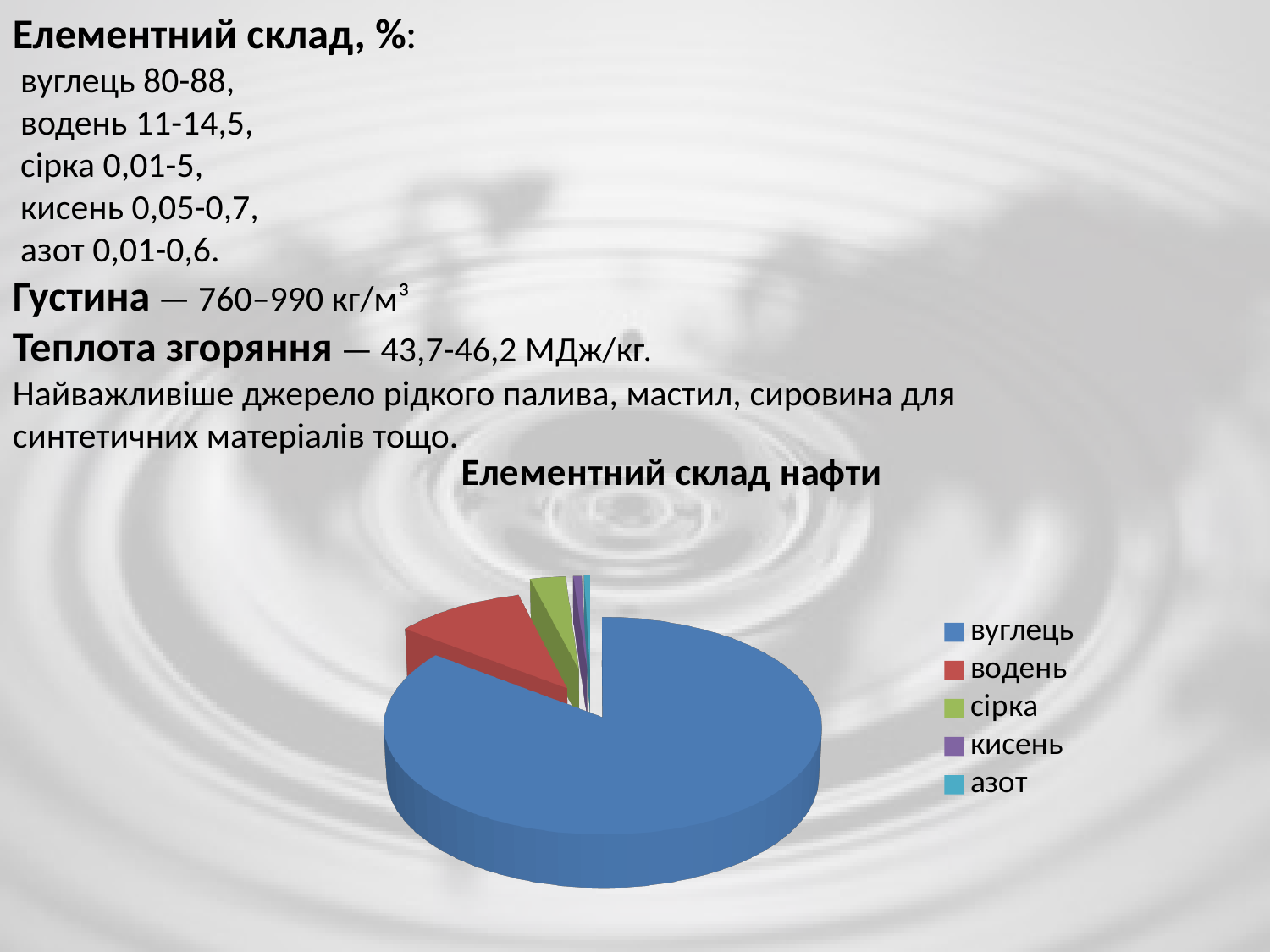
Which element has the second-largest slice in the pie chart? водень How many entries does the chart legend list? 5 What colour is the slice for вуглець? Blue How many slices does the pie chart have? 5 Which element has the largest slice in the pie chart? вуглець What kind of chart is shown on the slide? Pie chart What is the title of the chart? Елементний склад нафти Which slice is larger, водень or сірка? водень Which slice is larger, сірка or кисень? сірка Which legend entry is listed last? азот